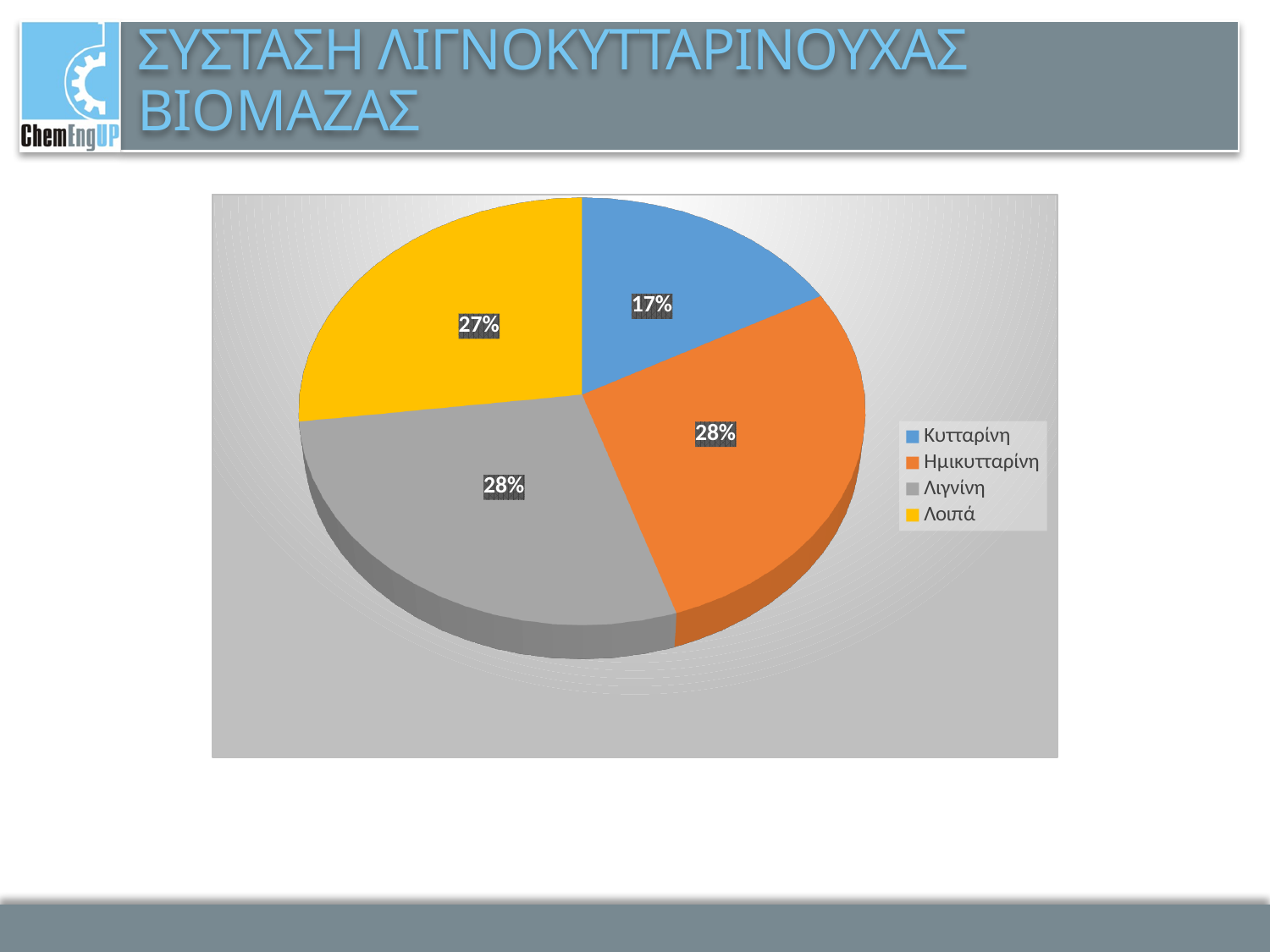
How many entries does the legend list? 4 Which category has the smallest slice of the pie? Κυτταρίνη Which legend entry is shown in orange? Ημικυτταρίνη What share of the pie does Κυτταρίνη represent? 17% What share of the pie does Λιγνίνη represent? 28% Which is larger, the slice for Κυτταρίνη or the slice for Λοιπά? Λοιπά What is the difference in percentage points between the Λιγνίνη slice and the Κυτταρίνη slice? 11 How many slices does the pie chart have? 4 What share of the pie does Ημικυτταρίνη represent? 28% What colour is the Λοιπά slice in the pie chart? yellow What kind of chart is shown on the slide? pie chart